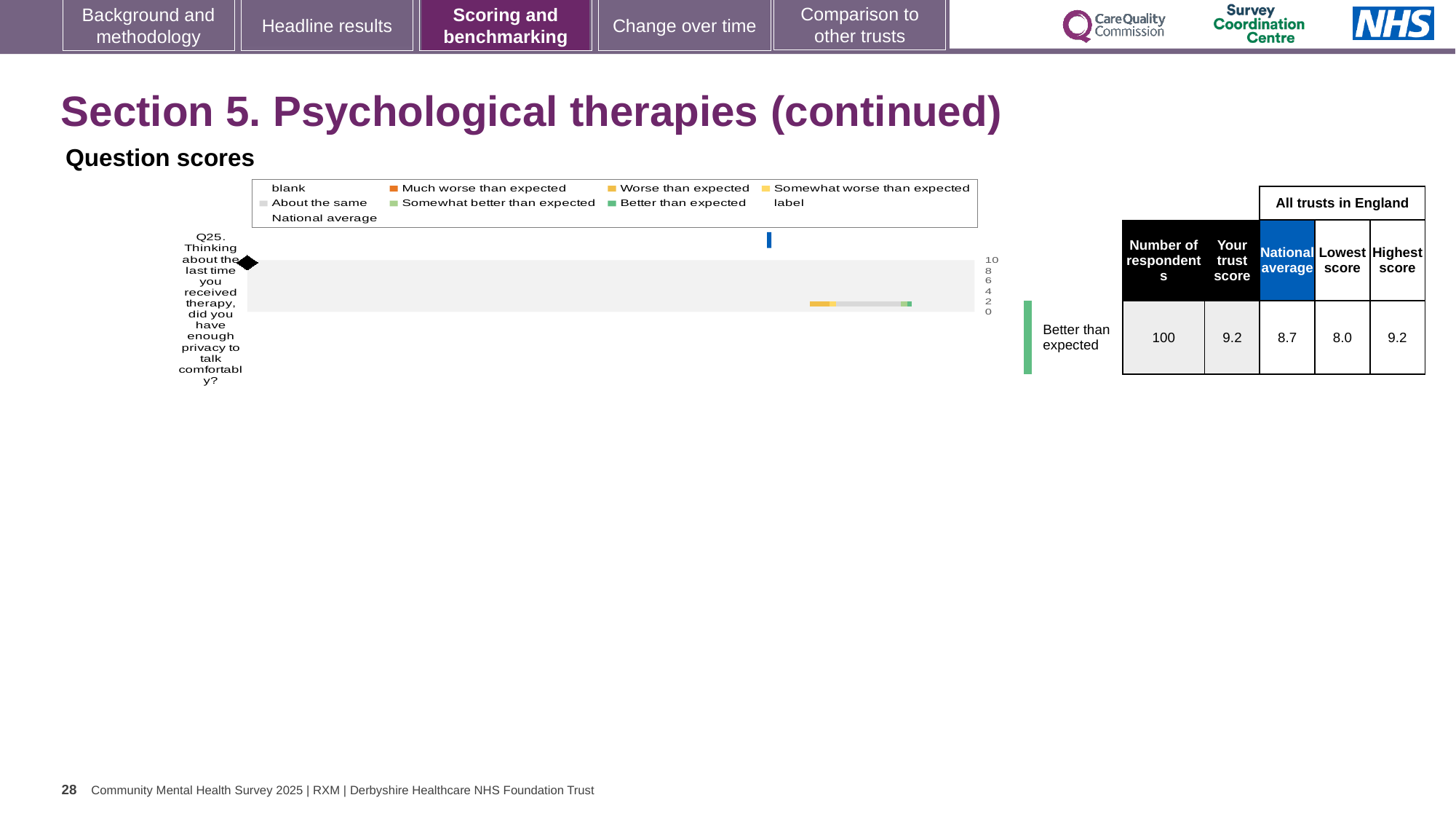
How many questions (categories) are plotted in the Question scores chart? 1 What is the lowest score across all trusts in England for Q25? 8.0 Which is larger for Q25, the trust score or the national average? trust score What rating is shown for Q25 next to the Question scores chart? Better than expected What kind of chart is shown under 'Question scores'? bar chart What is the number of respondents for Q25 shown in the table beside the chart? 100 What is the highest score across all trusts in England for Q25? 9.2 What is the highest tick value shown on the axis of the Question scores chart? 10 What is the national average for Q25 shown in the table beside the chart? 8.7 Which question is plotted in the Question scores chart? Q25. Thinking about the last time you received therapy, did you have enough privacy to talk comfortably? What is the trust score for Q25 shown in the table beside the chart? 9.2 What is the difference between the trust score and the national average for Q25? 0.5